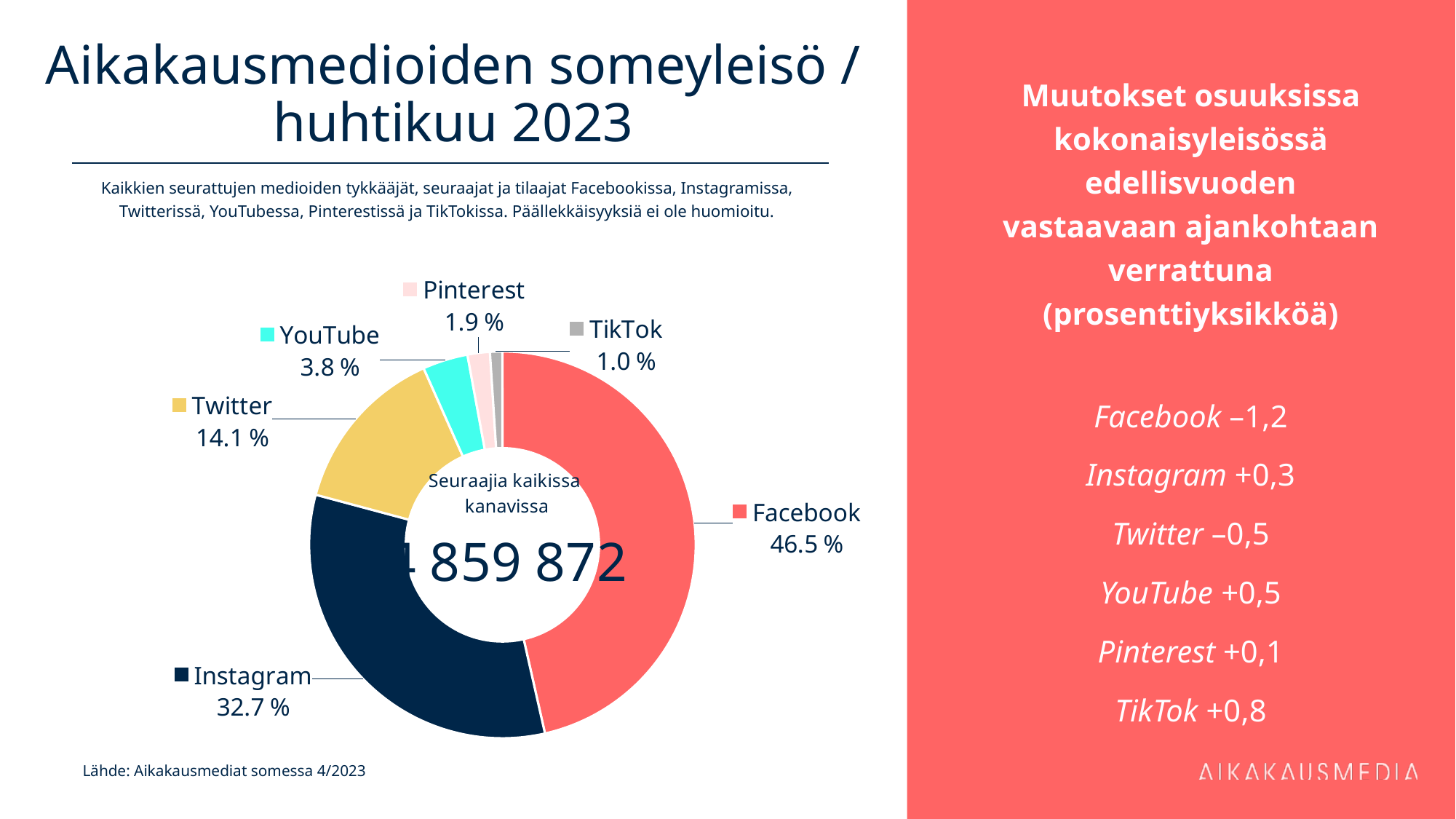
Which channel has the smallest share of the audience? TikTok How many channels (slices) are shown in the chart? 6 What kind of chart is shown on the slide? Pie chart (donut) What share does YouTube have in the chart? 3.8 % Which has a larger share, Twitter or YouTube? Twitter What share of the social media audience does Facebook have? 46.5 % What share does Twitter have in the chart? 14.1 % What share of the social media audience does Instagram have? 32.7 % Which channel has the largest share of the audience? Facebook What colour is the Instagram slice in the chart? Dark navy blue What share does TikTok have in the chart? 1.0 % What is the difference in percentage points between Facebook's and Instagram's shares? 13.8